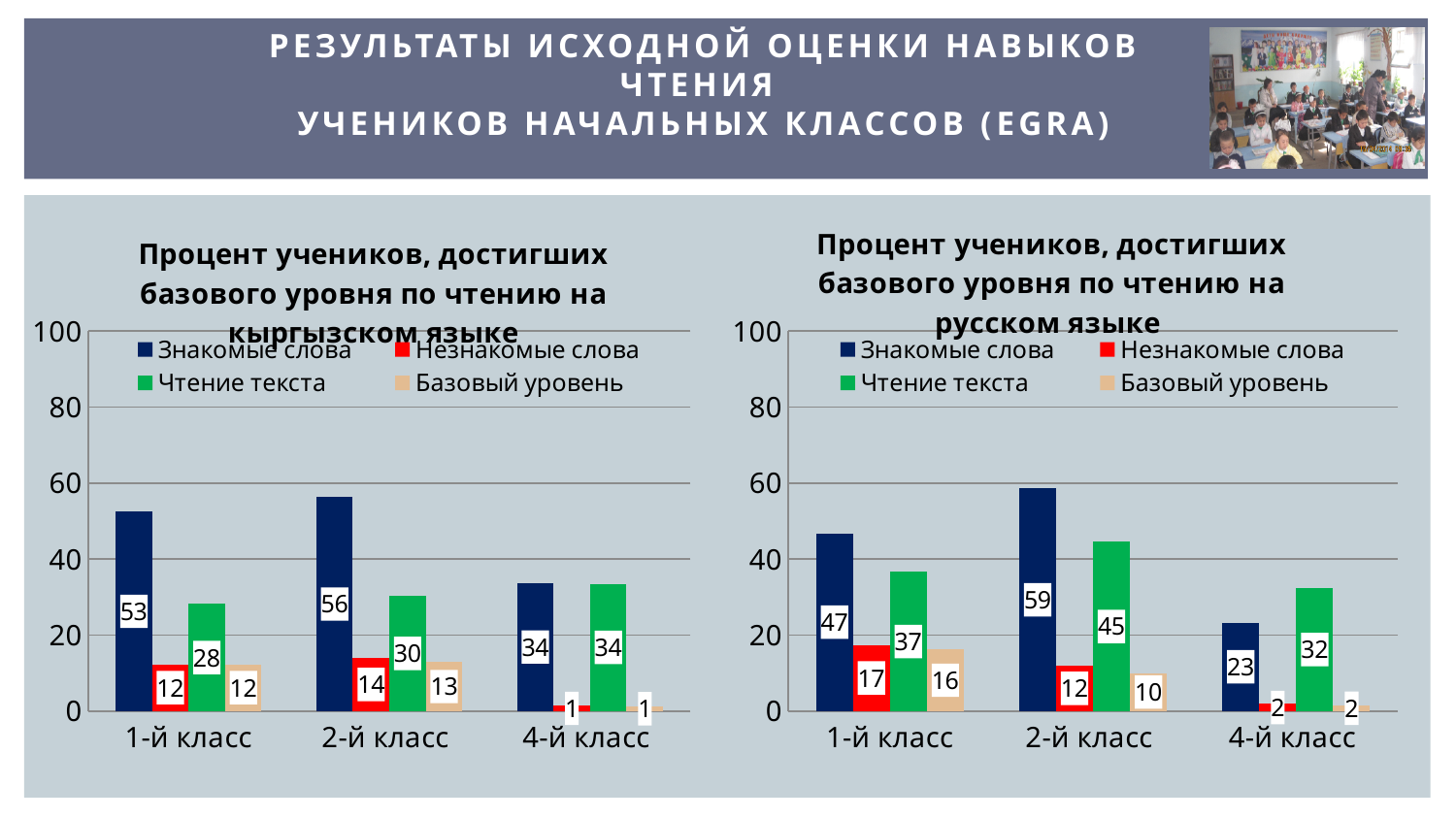
In the left chart (Kyrgyz language), what is the value for Базовый уровень in 4-й класс? 1 In the right chart (Russian language), which class has the lowest value for Базовый уровень? 4-й класс In the right chart (Russian language), what is the value for Чтение текста in 2-й класс? 45 In the right chart (Russian language), is the value for Знакомые слова in 1-й класс greater or less than 40? greater What type of chart is the left chart (Kyrgyz language)? bar chart How many series does the legend of the right chart (Russian language) list? 4 How many classes (categories) are shown on the x axis of the left chart (Kyrgyz language)? 3 In the right chart (Russian language), what is the difference between Знакомые слова in 2-й класс and in 4-й класс? 36 In the right chart (Russian language), what is the value for Базовый уровень in 1-й класс? 16 In the left chart (Kyrgyz language), which class has the highest value for Знакомые слова? 2-й класс In the left chart (Kyrgyz language), which is larger in 1-й класс: Знакомые слова or Чтение текста? Знакомые слова In the left chart (Kyrgyz language), what is the value for Знакомые слова in 2-й класс? 56